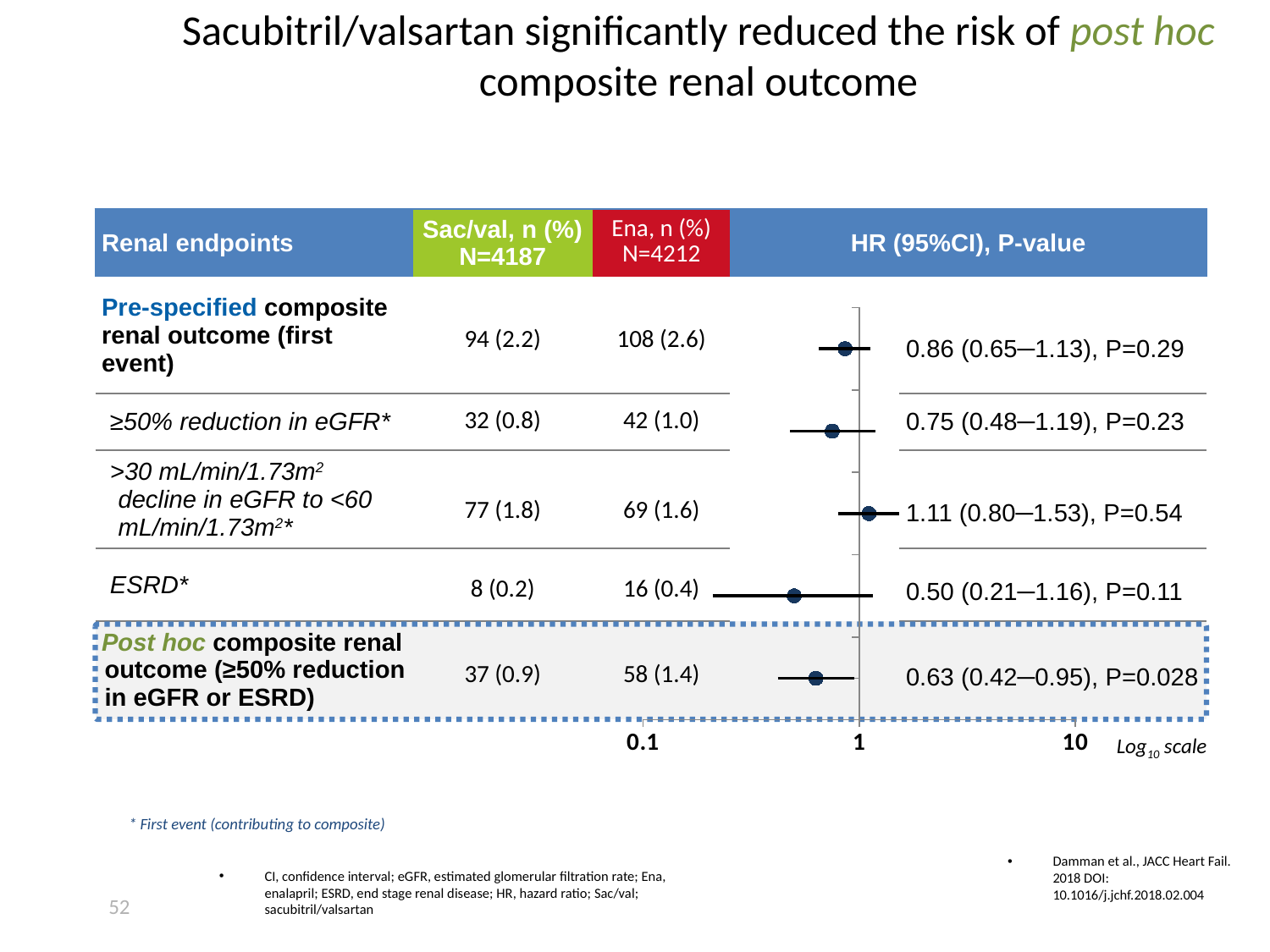
How many Sac/val patients had the ESRD* event, as shown in the table? 8 (0.2) Which renal endpoint has the lowest hazard ratio? ESRD* What is the P-value for the post hoc composite renal outcome (≥50% reduction in eGFR or ESRD)? P=0.028 Which renal endpoint has the highest hazard ratio? >30 mL/min/1.73m² decline in eGFR to <60 mL/min/1.73m²* Is the hazard ratio for the ≥50% reduction in eGFR* endpoint greater or less than 1? less What kind of chart is shown on the slide? Forest plot How many renal endpoints are plotted in the forest plot? 5 What is the 95% CI for the hazard ratio of the pre-specified composite renal outcome (first event)? 0.65–1.13 What is the difference between the hazard ratios of the pre-specified composite renal outcome and the post hoc composite renal outcome? 0.23 Which has a larger hazard ratio: the pre-specified composite renal outcome or the post hoc composite renal outcome? Pre-specified composite renal outcome What is the hazard ratio for the ESRD* endpoint? 0.50 What scale is used on the x axis of the forest plot? Log10 scale